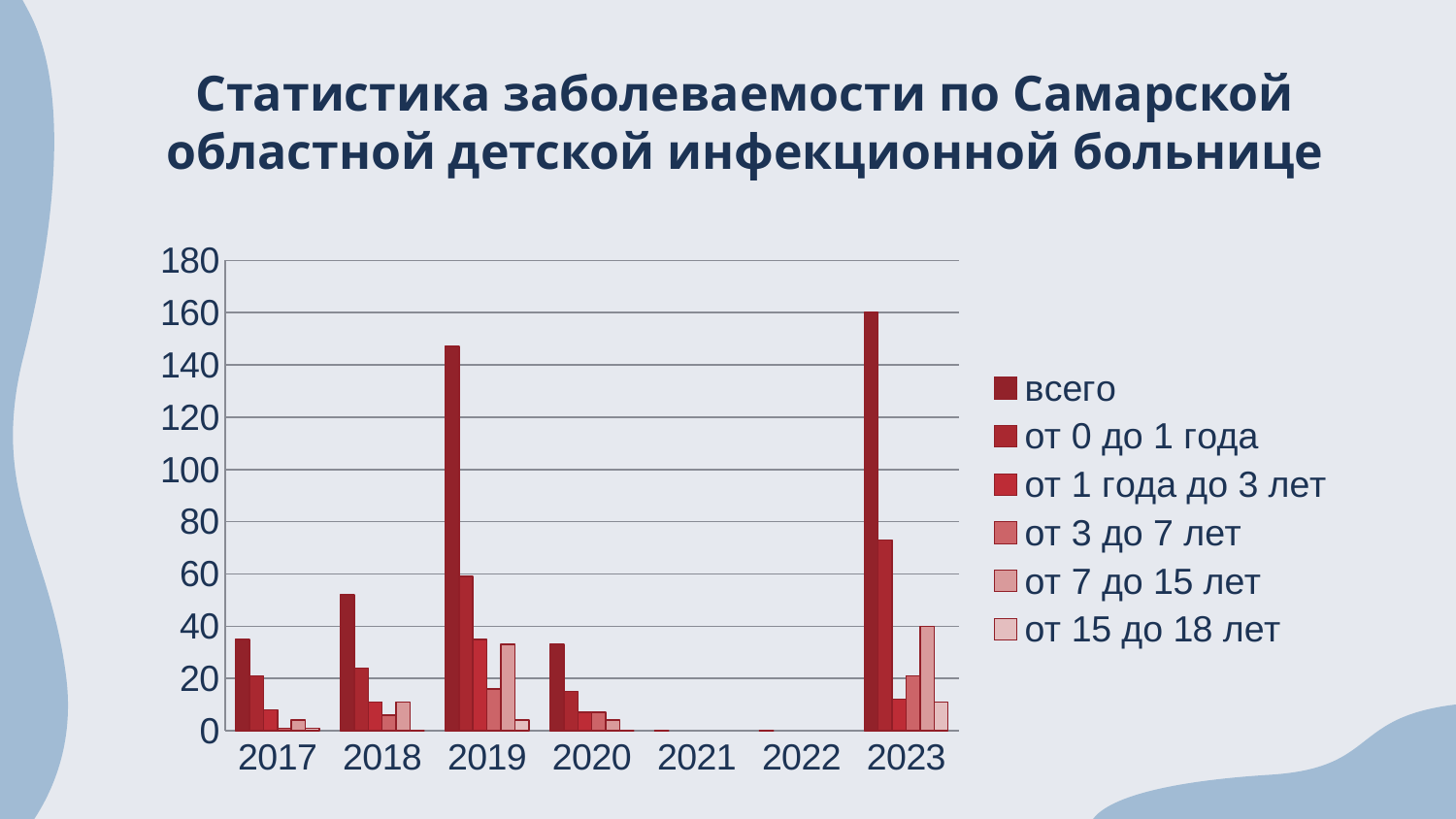
Is the "всего" value for 2019 greater or less than 140? greater Is the "от 0 до 1 года" value for 2023 greater or less than 60? greater What is the first entry in the chart's legend? всего Is the "всего" value for 2018 greater or less than 40? greater How many series does the chart's legend list? 6 In which year is the "всего" bar the highest? 2023 Which is larger: the "всего" value for 2023 or for 2019? 2023 Which is larger: the "всего" value for 2018 or for 2020? 2018 How many years are shown on the x axis of the chart? 7 What kind of chart is shown on the slide? bar chart